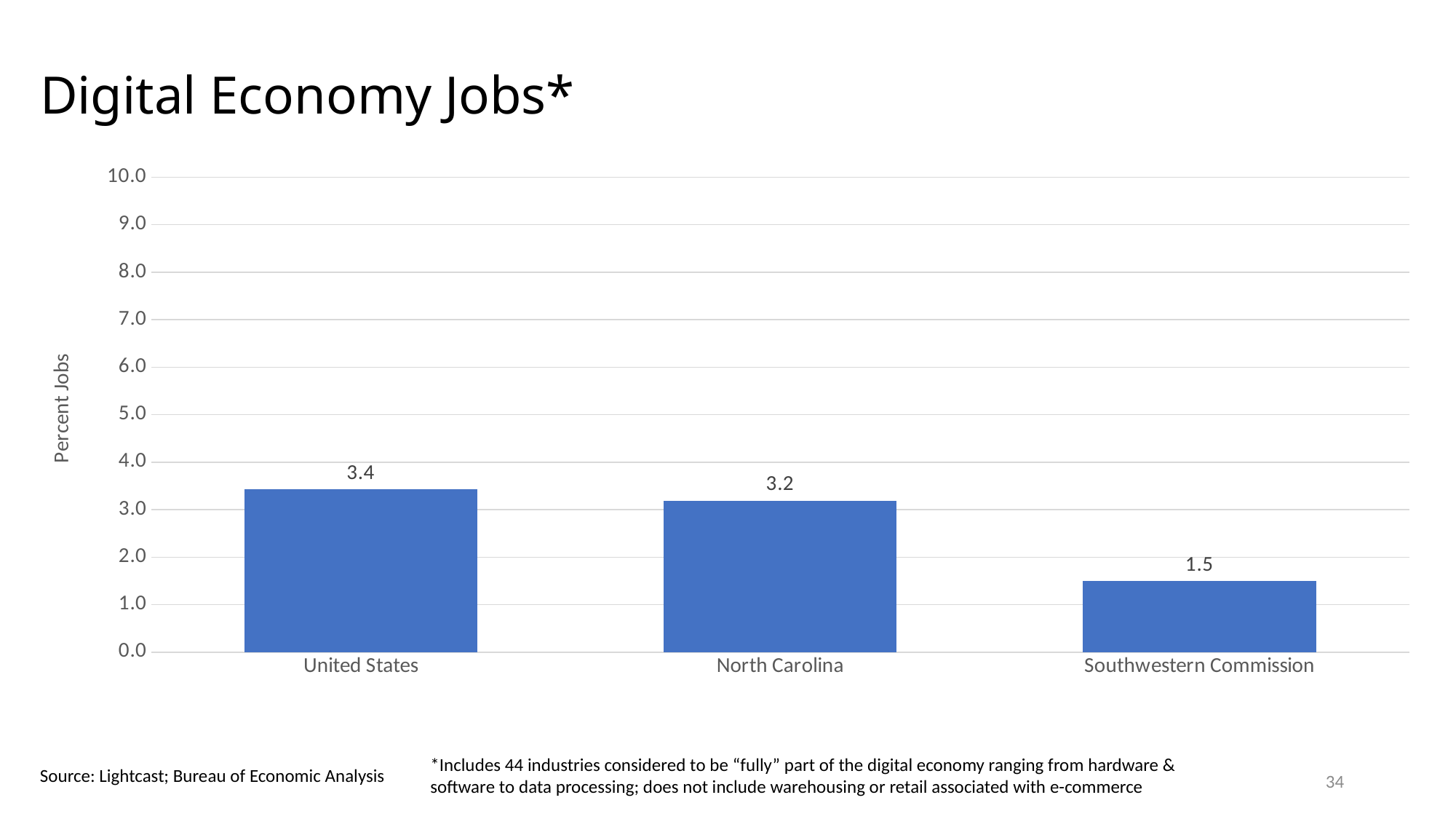
How many categories are shown on the chart? 3 Which category has the highest value? United States What is the difference between the values for North Carolina and Southwestern Commission? 1.7 Is the value for Southwestern Commission greater or less than 2.0? less What is the value for North Carolina? 3.2 What is the label on the vertical axis of the chart? Percent Jobs Which category has the lowest value? Southwestern Commission What is the difference between the values for United States and Southwestern Commission? 1.9 Which is larger, the value for North Carolina or the value for Southwestern Commission? North Carolina What kind of chart is shown on the slide? bar chart What is the value for United States? 3.4 What is the value for Southwestern Commission? 1.5